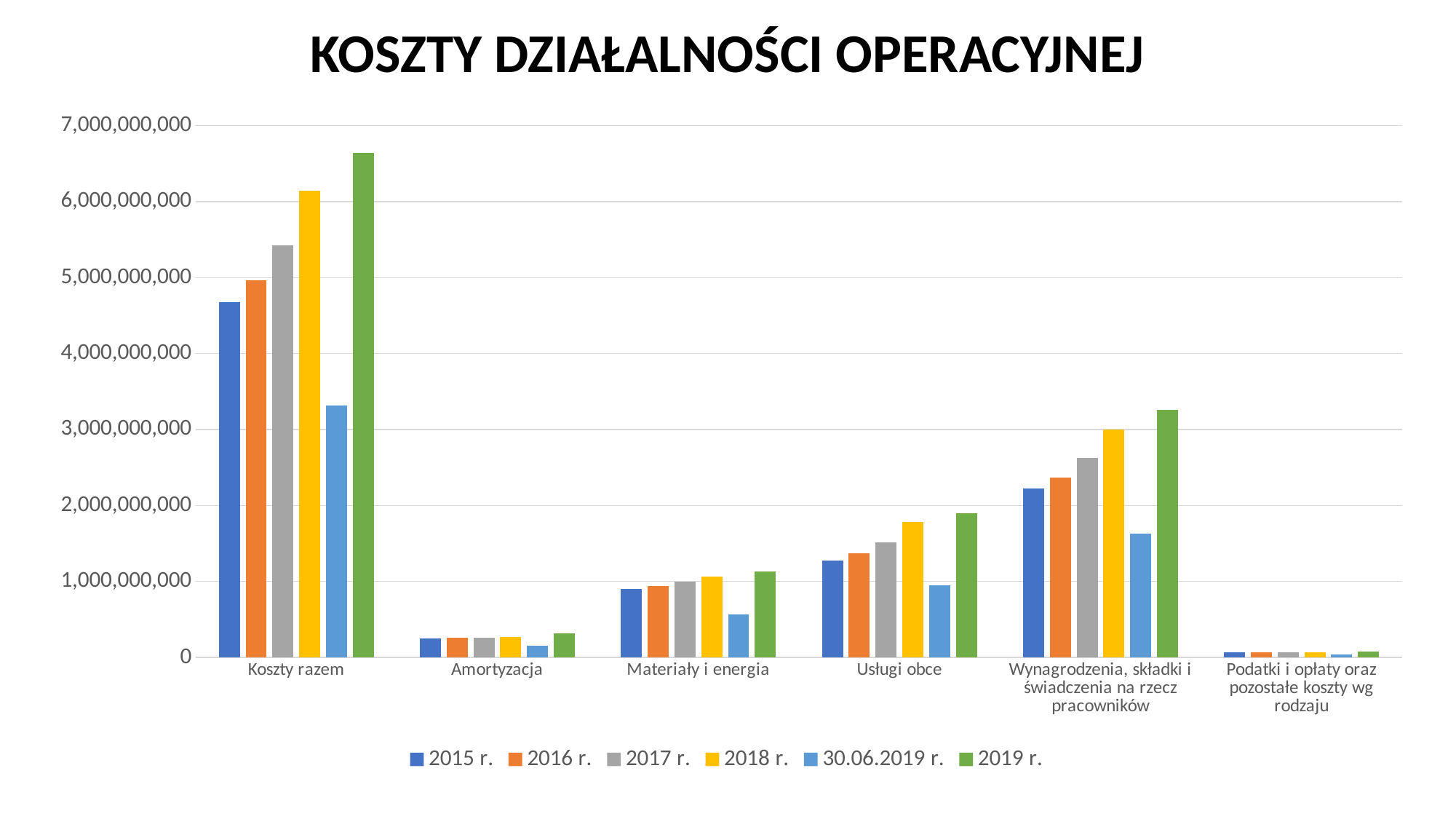
Is the 2019 r. value for Koszty razem greater or less than 6,000,000,000? greater Is the 30.06.2019 r. value for Koszty razem greater or less than 3,000,000,000? greater Is the 2019 r. value for Wynagrodzenia, składki i świadczenia na rzecz pracowników greater or less than 3,000,000,000? greater How many series does the legend list? 6 For Koszty razem, do the values rise or fall from 2015 r. through 2018 r.? rise What kind of chart is shown on the slide? bar chart For the 2018 r. series, which is larger: Usługi obce or Wynagrodzenia, składki i świadczenia na rzecz pracowników? Wynagrodzenia, składki i świadczenia na rzecz pracowników How many categories are shown on the x axis? 6 Which category has the lowest value for the 2019 r. series? Podatki i opłaty oraz pozostałe koszty wg rodzaju For the 2017 r. series, which is larger: Materiały i energia or Usługi obce? Usługi obce Which category has the highest value for the 2019 r. series? Koszty razem